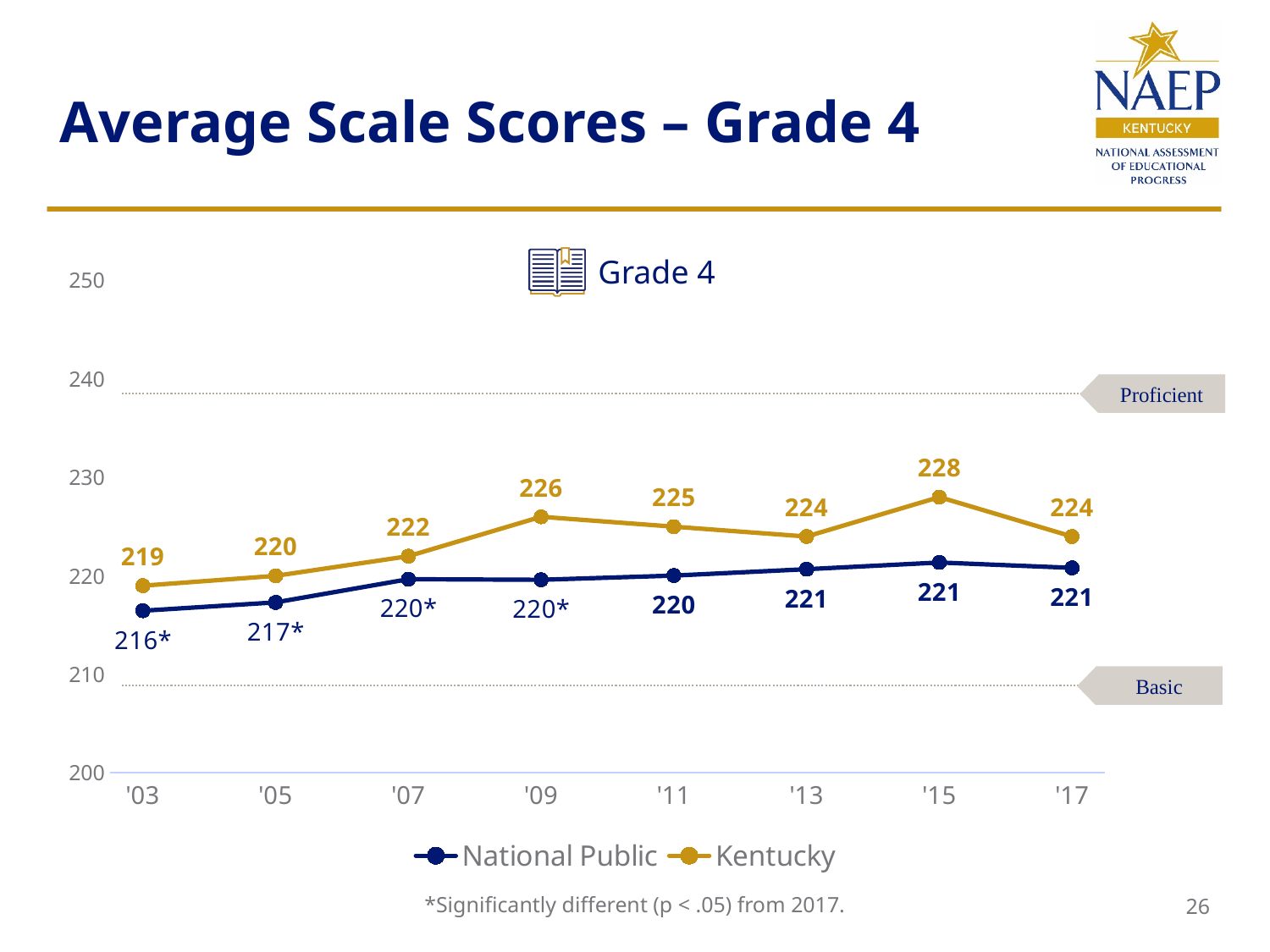
In which year does Kentucky reach its highest average scale score? '15 What kind of chart is shown on the slide? line chart What is the National Public average scale score for '17? 221 What is the Kentucky average scale score for '15? 228 What is the Kentucky average scale score for '09? 226 How many years are plotted on the x axis? 8 Is the Kentucky score for '15 greater or less than 230? less In which year is the National Public average scale score lowest? '03 What is the National Public average scale score for '03? 216* Which series has the higher score in '17, National Public or Kentucky? Kentucky How many series does the legend list? 2 What is the difference between the Kentucky and National Public scores in '15? 7